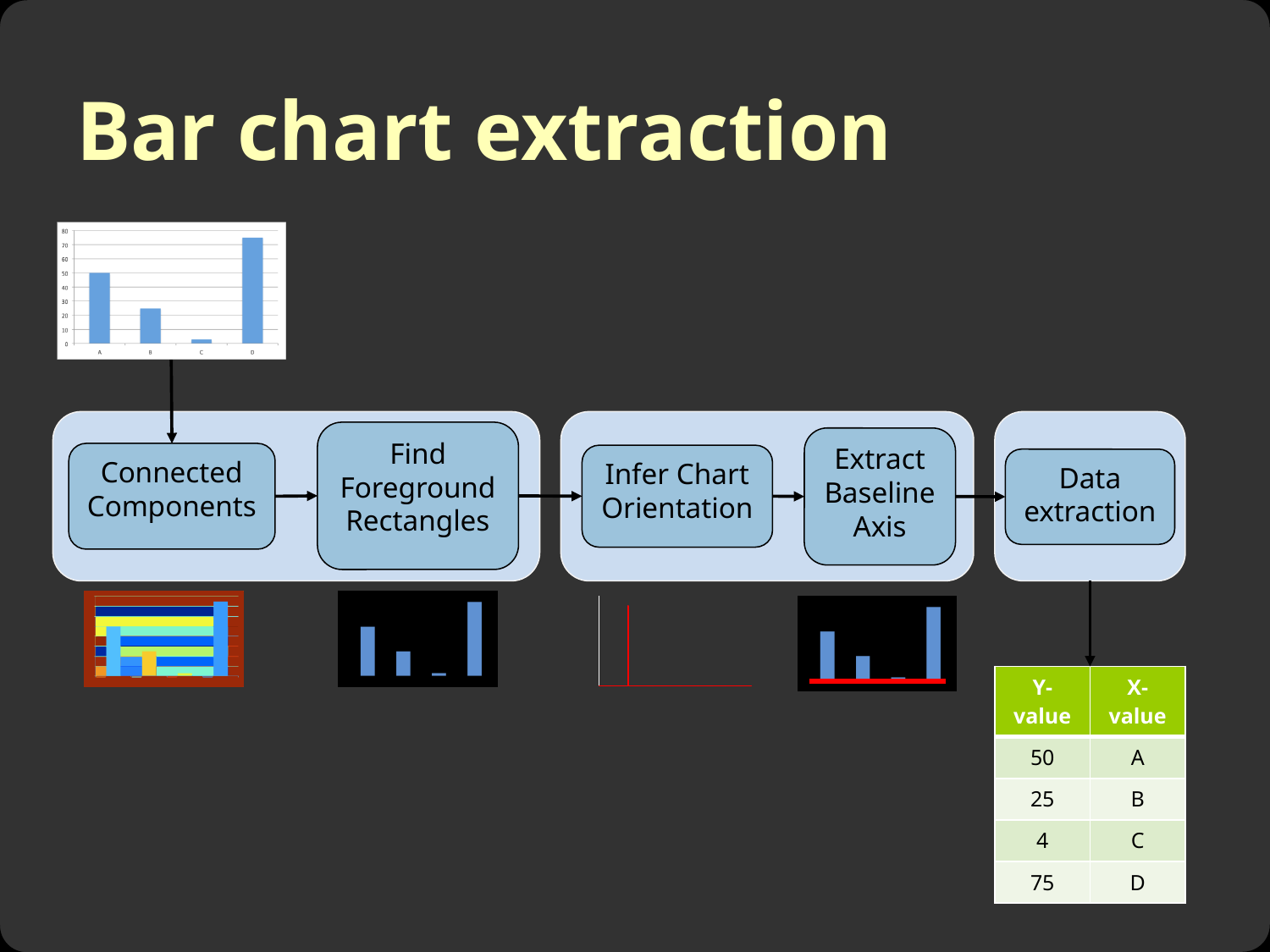
In the bar chart at the top left, what is the value for category A? 50 In the bar chart at the top left, which is larger, the value for A or the value for B? A In the bar chart at the top left, which category has the highest bar? D In the bar chart at the top left, what is the highest tick value shown on the y axis? 80 In the bar chart at the top left, which category has the lowest bar? C In the bar chart at the top left, which is larger, the value for C or the value for D? D In the bar chart at the top left, what are the category labels on the x axis? A, B, C, D What kind of chart is shown at the top left of the slide? bar chart In the bar chart at the top left, is the value for D greater or less than 70? greater In the bar chart at the top left, is the value for C greater or less than 10? less In the bar chart at the top left, how many categories are shown on the x axis? 4 In the bar chart at the top left, is the value for B greater or less than 30? less